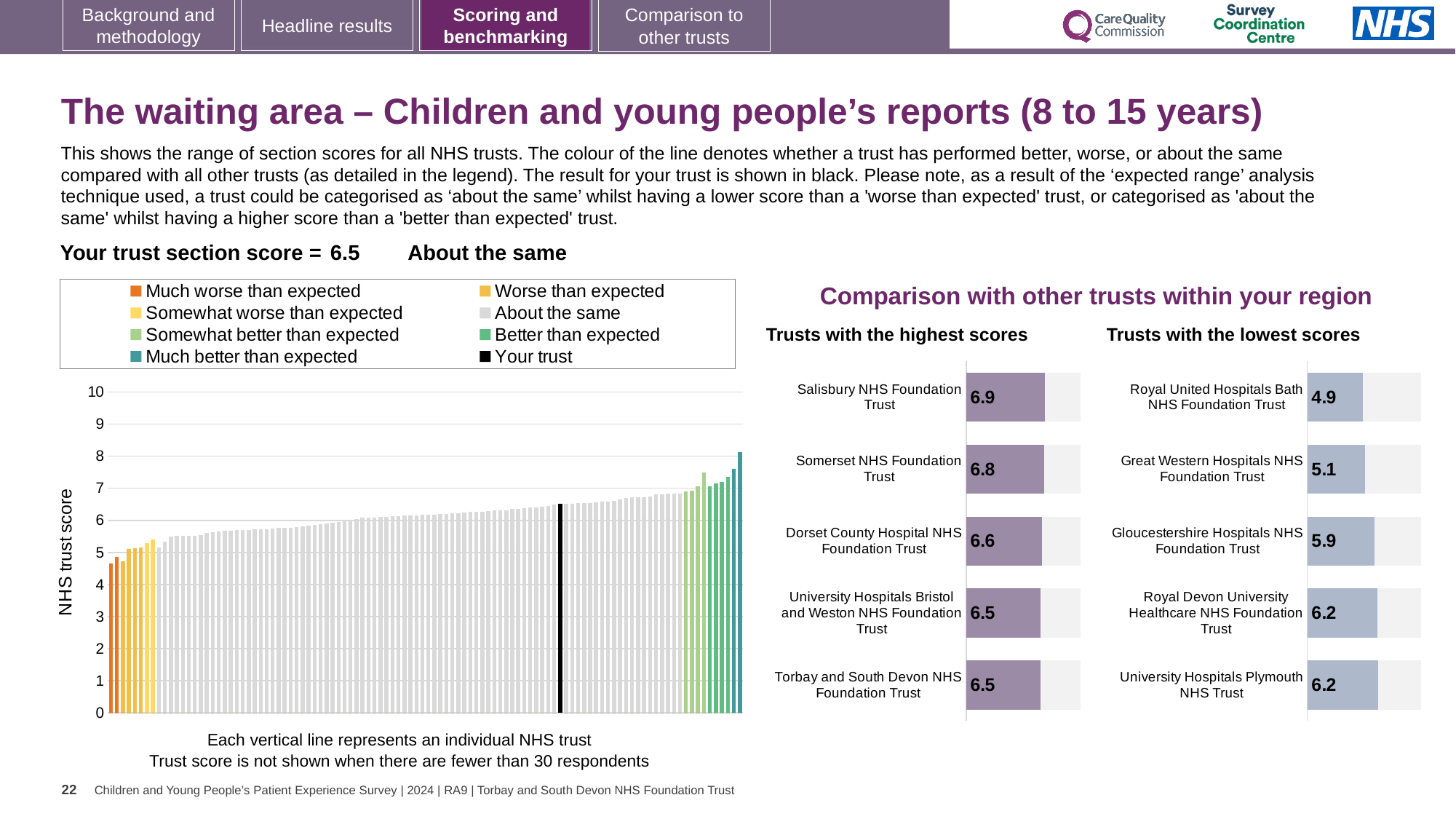
Which has the higher score: Dorset County Hospital NHS Foundation Trust in the highest scores chart or Gloucestershire Hospitals NHS Foundation Trust in the lowest scores chart? Dorset County Hospital NHS Foundation Trust In the 'Trusts with the highest scores' chart, which trust has the highest score? Salisbury NHS Foundation Trust In the main 'NHS trust score' chart, do the bar values rise or fall from left to right? Rise What kind of chart is the main 'NHS trust score' chart on the left of the slide? Bar chart In the main 'NHS trust score' chart, what is the section score for your trust (the black bar)? 6.5 How many trusts are listed in the 'Trusts with the highest scores' chart? 5 In the 'Trusts with the highest scores' chart, what is the score for Salisbury NHS Foundation Trust? 6.9 In the 'Trusts with the lowest scores' chart, which trust has the lowest score? Royal United Hospitals Bath NHS Foundation Trust How many entries does the legend above the main 'NHS trust score' chart list? 8 In the 'Trusts with the highest scores' chart, what is the difference between the scores of Salisbury NHS Foundation Trust and Somerset NHS Foundation Trust? 0.1 In the 'Trusts with the lowest scores' chart, what is the difference between the scores of Gloucestershire Hospitals NHS Foundation Trust and Great Western Hospitals NHS Foundation Trust? 0.8 In the 'Trusts with the lowest scores' chart, what is the score for Royal United Hospitals Bath NHS Foundation Trust? 4.9